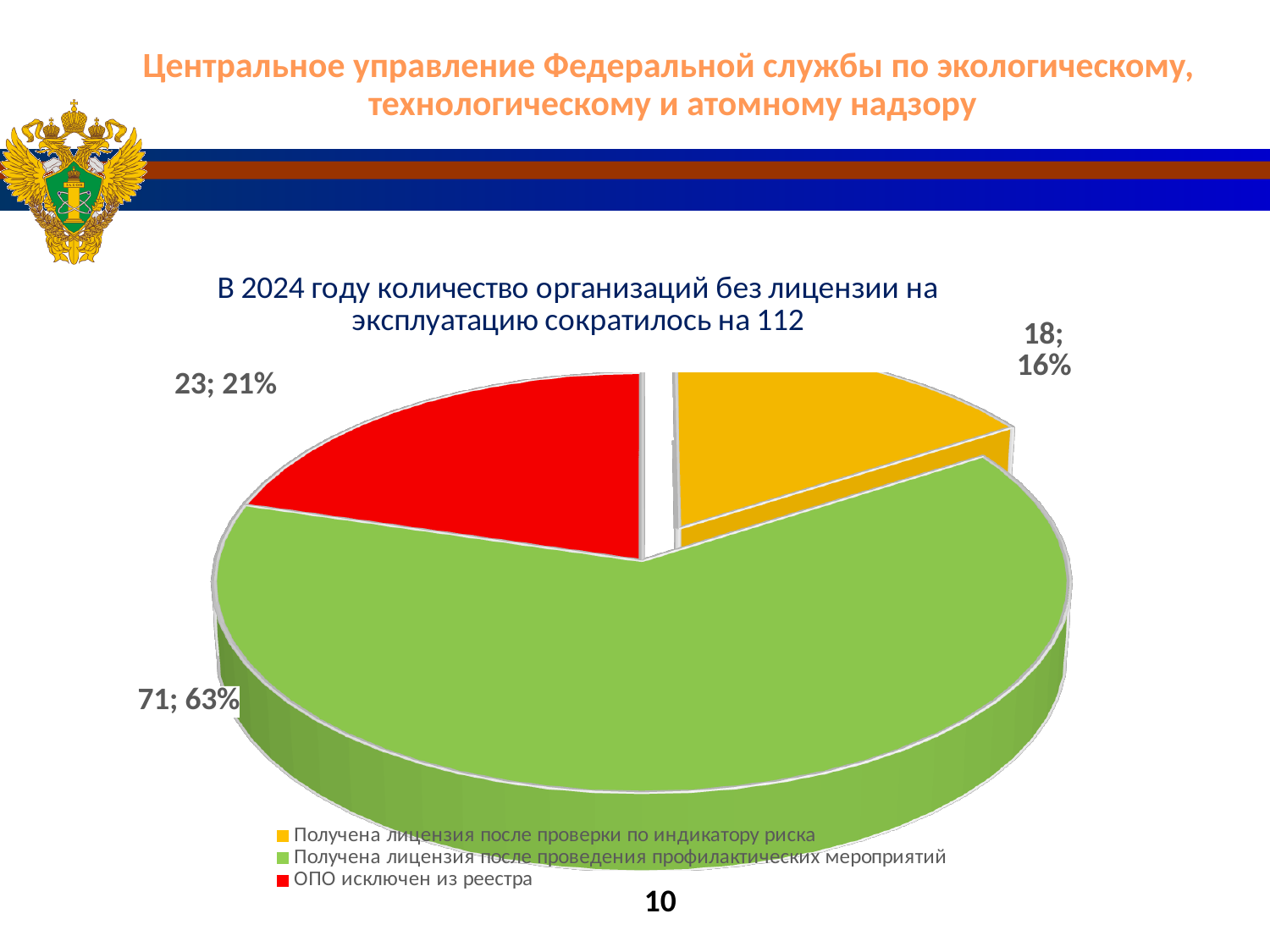
Какой тип диаграммы показан на слайде? Круговая диаграмма Сколько категорий (секторов) показано на круговой диаграмме? 3 Какую долю круговой диаграммы занимает категория «ОПО исключен из реестра»? 21% Какое значение соответствует категории «ОПО исключен из реестра»? 23 Какая категория имеет наименьшее значение на диаграмме? Получена лицензия после проверки по индикатору риска Какое значение соответствует категории «Получена лицензия после проведения профилактических мероприятий»? 71 Какая категория имеет наибольшее значение на диаграмме? Получена лицензия после проведения профилактических мероприятий Какую долю круговой диаграммы занимает категория «Получена лицензия после проверки по индикатору риска»? 16% Каким цветом на диаграмме обозначена категория «ОПО исключен из реестра»? Красным На сколько значение категории «Получена лицензия после проведения профилактических мероприятий» больше значения категории «ОПО исключен из реестра»? 48 Какое значение соответствует категории «Получена лицензия после проверки по индикатору риска»? 18 Что больше: значение категории «ОПО исключен из реестра» или категории «Получена лицензия после проверки по индикатору риска»? ОПО исключен из реестра